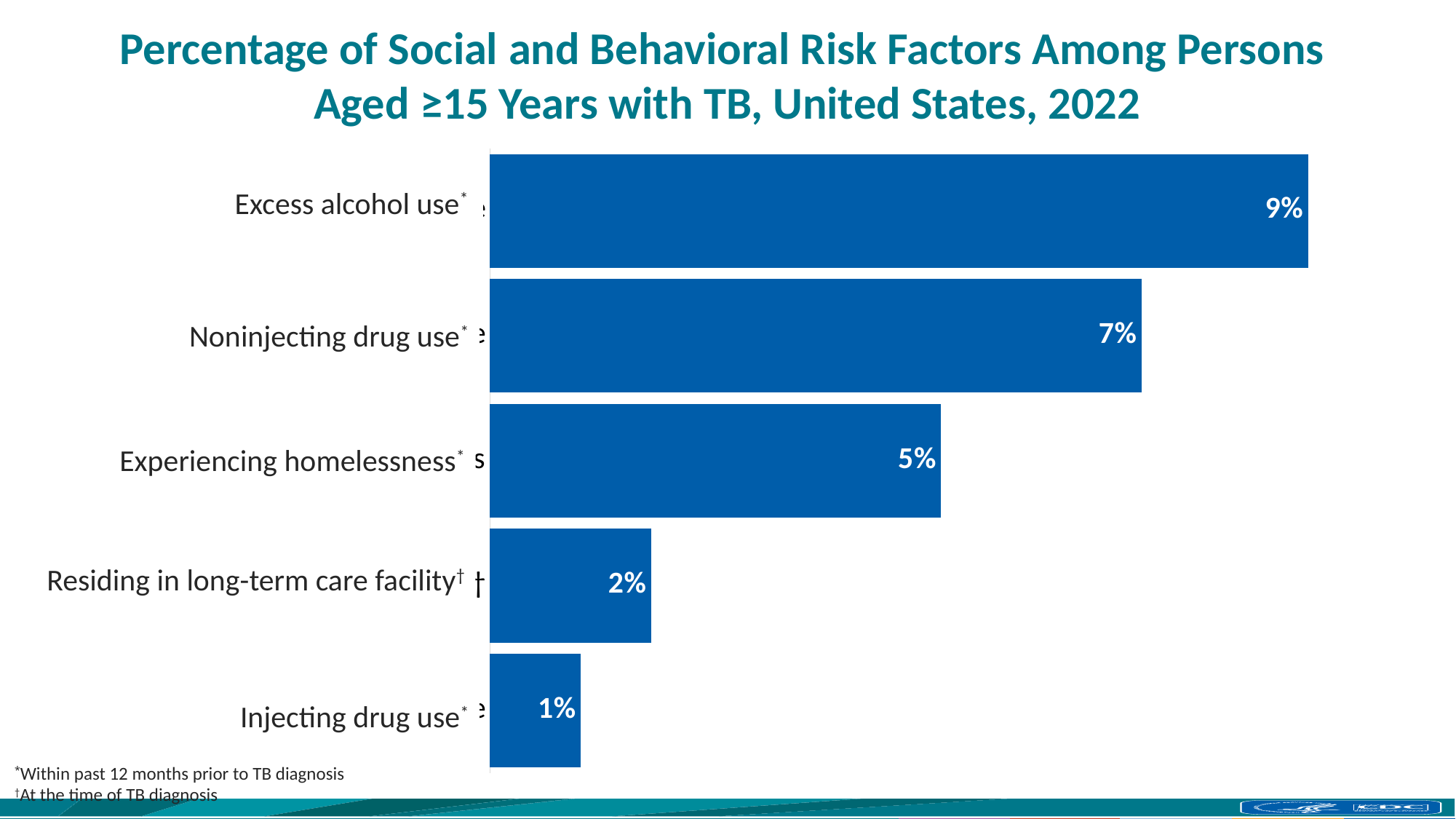
What percentage is shown for Residing in long-term care facility? 2% What percentage is shown for Injecting drug use? 1% What is the difference in percentage points between Excess alcohol use and Noninjecting drug use? 2 What kind of chart is shown on the slide? Bar chart What percentage is shown for Noninjecting drug use? 7% Which risk factor has the highest percentage? Excess alcohol use How many risk factor categories are shown in the chart? 5 What percentage is shown for Experiencing homelessness? 5% Which is larger, the percentage for Experiencing homelessness or for Residing in long-term care facility? Experiencing homelessness What percentage is shown for Excess alcohol use? 9% Which risk factor has the lowest percentage? Injecting drug use What year does the chart title say the data are for? 2022